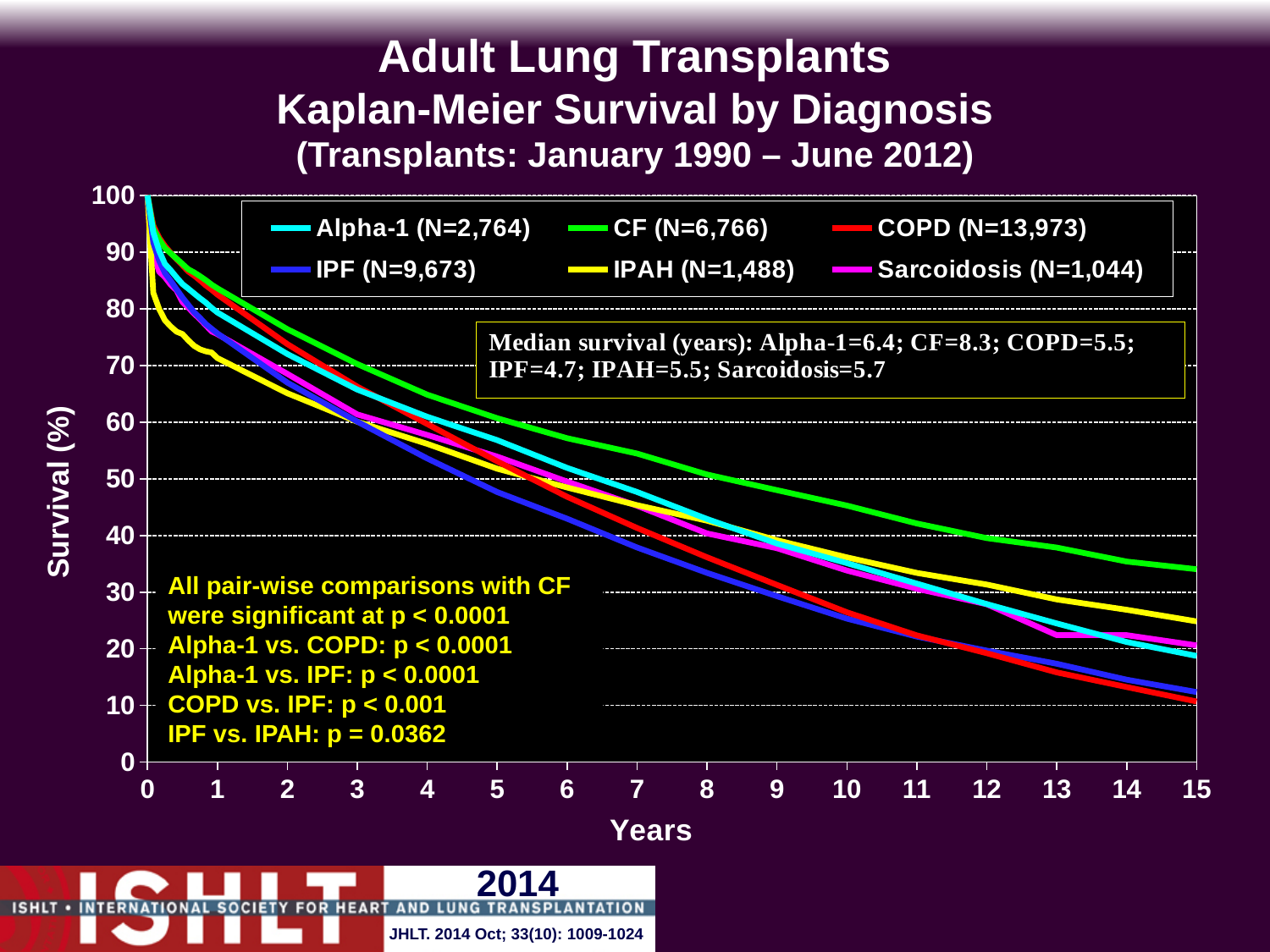
Is the survival value for CF at 15 years greater or less than 30? greater What is the difference in median survival (years) between CF and IPF? 3.6 Which diagnosis group has the lowest median survival listed in the text box? IPF Is the survival value for IPF at 5 years greater or less than 50? less According to the text box, what is the median survival in years for CF? 8.3 According to the text box, what is the median survival in years for IPF? 4.7 How many diagnosis groups (series) does the legend list? 6 At 10 years, which has the higher survival: CF or IPF? CF Do the survival curves rise or fall as years increase? fall What kind of chart is shown on the slide? line chart Which diagnosis group has the highest median survival listed in the text box? CF Which diagnosis group has the highest survival curve at 15 years? CF